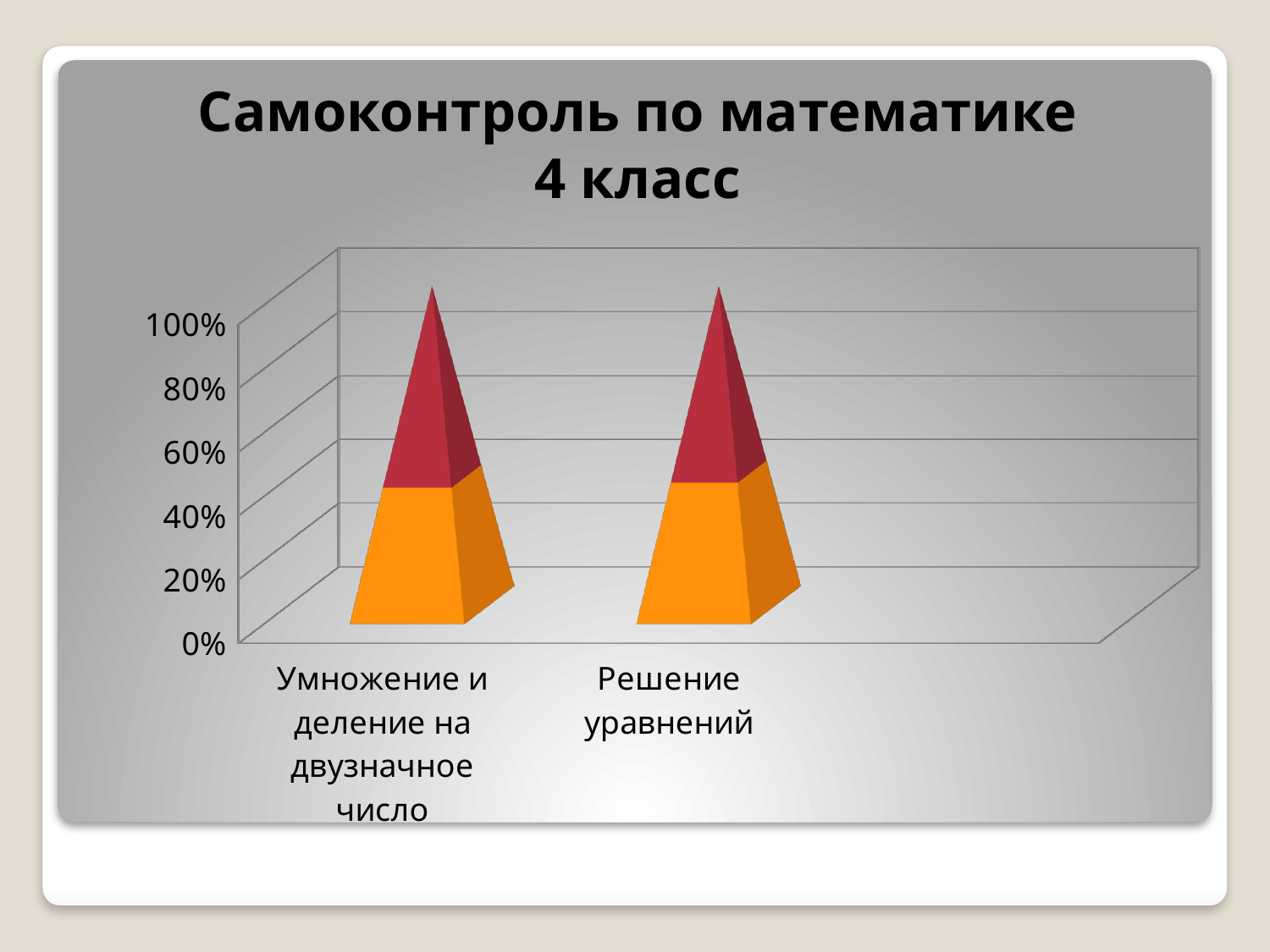
Is the total height of the bar for 'Умножение и деление на двузначное число' greater or less than 80%? greater What is the highest value shown on the vertical axis of the chart? 100% Is the total height of the bar for 'Решение уравнений' greater or less than 80%? greater What is the title of the slide containing the chart? Самоконтроль по математике 4 класс How many categories are shown on the x axis of the chart? 2 Is the orange segment of the bar for 'Умножение и деление на двузначное число' greater or less than 20%? greater What kind of chart is shown on the slide? Bar chart (stacked) What is the label of the second category on the x axis of the chart? Решение уравнений